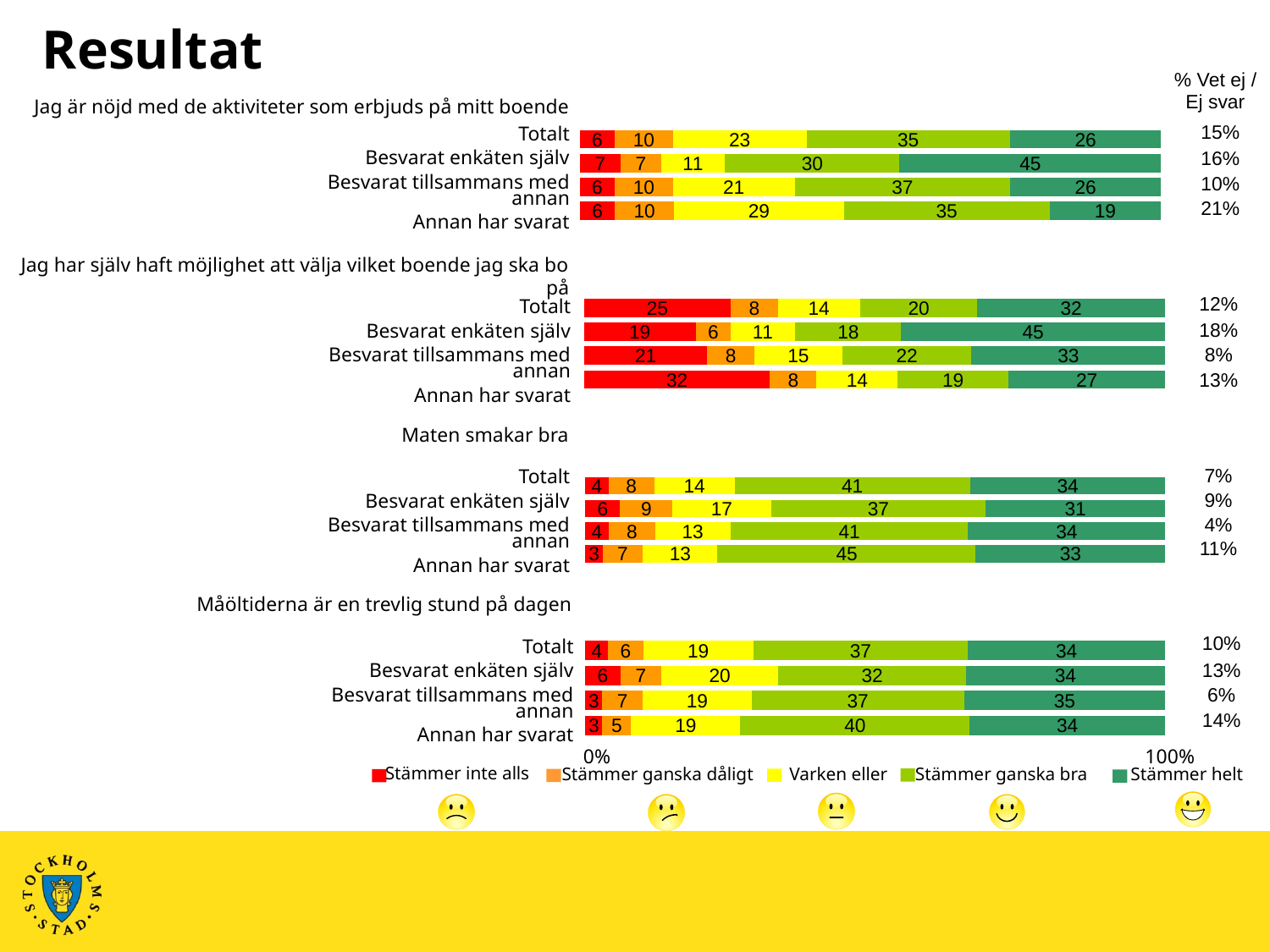
What is the 'Stämmer helt' value for 'Besvarat enkäten själv' under 'Jag är nöjd med de aktiviteter som erbjuds på mitt boende'? 45 What is the '% Vet ej / Ej svar' value for 'Annan har svarat' under 'Jag är nöjd med de aktiviteter som erbjuds på mitt boende'? 21% What is the label of the first (red) series in the legend? Stämmer inte alls Under 'Maten smakar bra', what is the difference between the 'Stämmer ganska bra' values for 'Annan har svarat' and 'Besvarat enkäten själv'? 8 What is the 'Stämmer inte alls' value for 'Annan har svarat' under 'Jag har själv haft möjlighet att välja vilket boende jag ska bo på'? 32 How many series does the legend list? 5 Under 'Jag är nöjd med de aktiviteter som erbjuds på mitt boende', which row has the lowest 'Stämmer helt' value? Annan har svarat What type of chart is shown on the slide? Stacked bar chart What is the 'Stämmer ganska bra' value for 'Annan har svarat' under 'Maten smakar bra'? 45 Under 'Jag har själv haft möjlighet att välja vilket boende jag ska bo på', which row has the highest 'Stämmer inte alls' value? Annan har svarat What is the 'Varken eller' value for 'Totalt' under 'Måöltiderna är en trevlig stund på dagen'? 19 Under 'Jag är nöjd med de aktiviteter som erbjuds på mitt boende', which is larger: the 'Varken eller' value for 'Annan har svarat' or for 'Totalt'? Annan har svarat